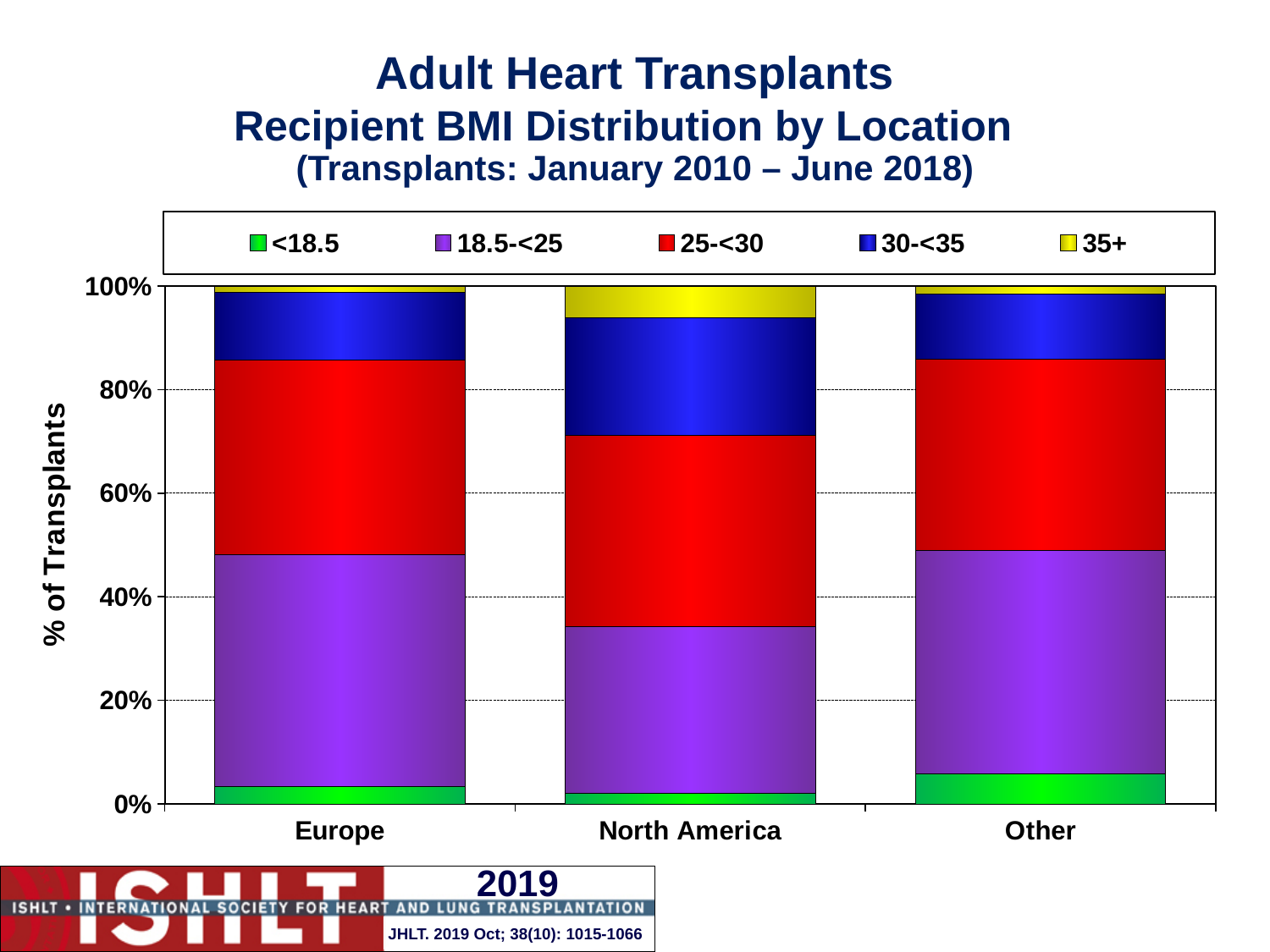
How many locations are shown on the x axis of the chart? 3 Which location has the largest share of recipients with BMI 35+? North America Which location has the largest share of recipients with BMI 30-<35? North America Is the share of recipients with BMI 30-<35 in North America greater or less than 20%? greater Which BMI category is shown in yellow in the legend? 35+ Which location has the largest share of recipients with BMI <18.5? Other What is the label of the y axis? % of Transplants What kind of chart is shown on the slide? Stacked bar chart How many BMI categories does the legend list? 5 Which location has the smallest share of recipients with BMI 18.5-<25? North America Is the share of recipients with BMI 35+ in North America greater or less than 10%? less Is the share of recipients with BMI 18.5-<25 larger for Europe or for North America? Europe